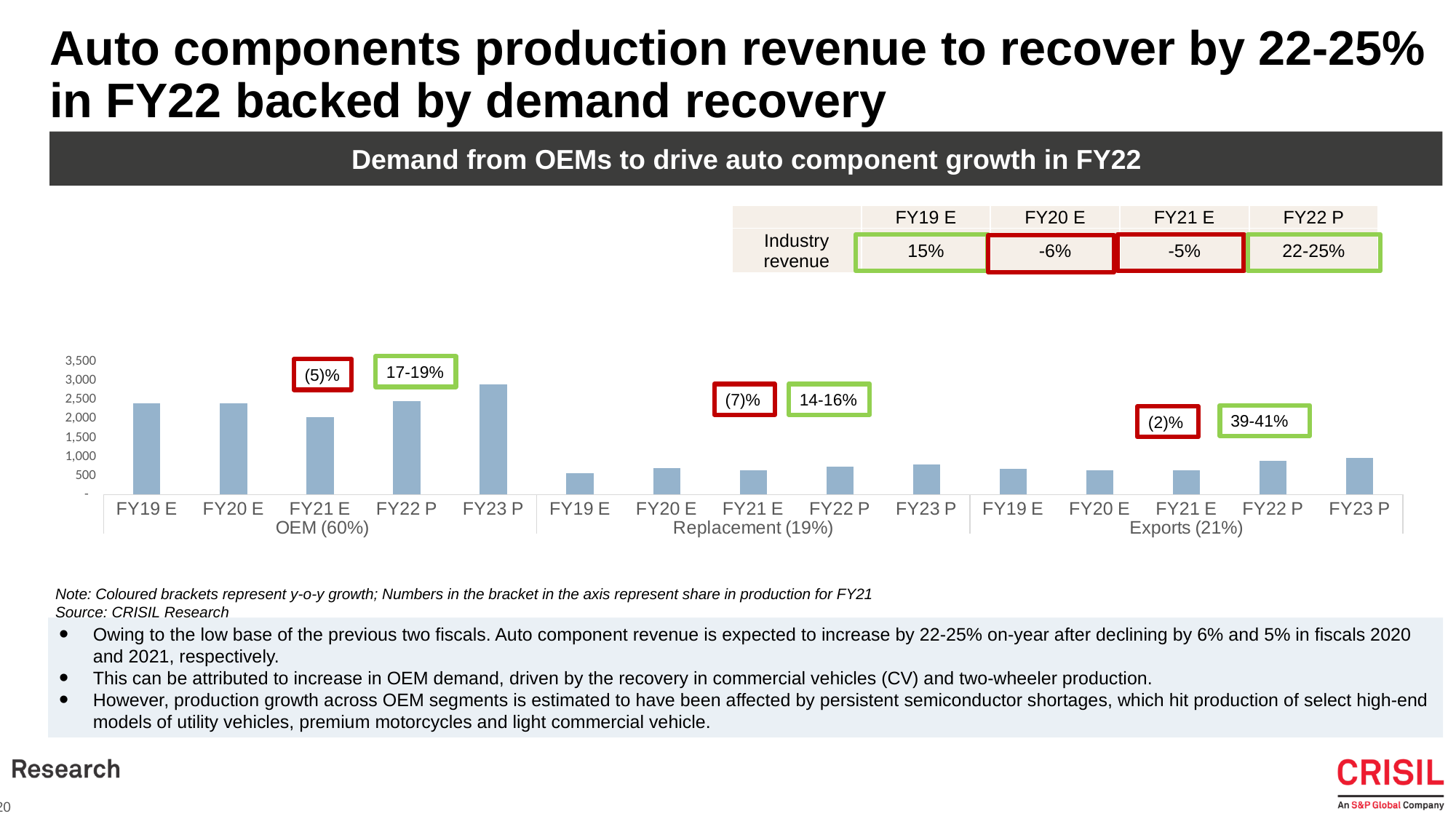
How many bars are plotted in the chart in total? 15 Is the value for FY23 P in the OEM (60%) group greater or less than 2,500? greater Is the value for FY23 P in the Replacement (19%) group greater or less than 1,000? less Which is larger in the OEM (60%) group: the FY21 E bar or the FY22 P bar? FY22 P What y-o-y growth is shown in the green bracket for FY22 P in the Exports (21%) group? 39-41% Do the bars in the OEM (60%) group rise or fall from FY21 E to FY23 P? rise What y-o-y growth is shown in the red bracket for FY21 E in the Replacement (19%) group? (7)% Which fiscal year has the tallest bar in the Replacement (19%) group? FY23 P How many segment groups (OEM, Replacement, Exports) does the chart's x axis show? 3 Which fiscal year has the tallest bar in the OEM (60%) group? FY23 P What kind of chart is shown on the slide? bar chart Is the value for FY19 E in the OEM (60%) group greater or less than 2,000? greater